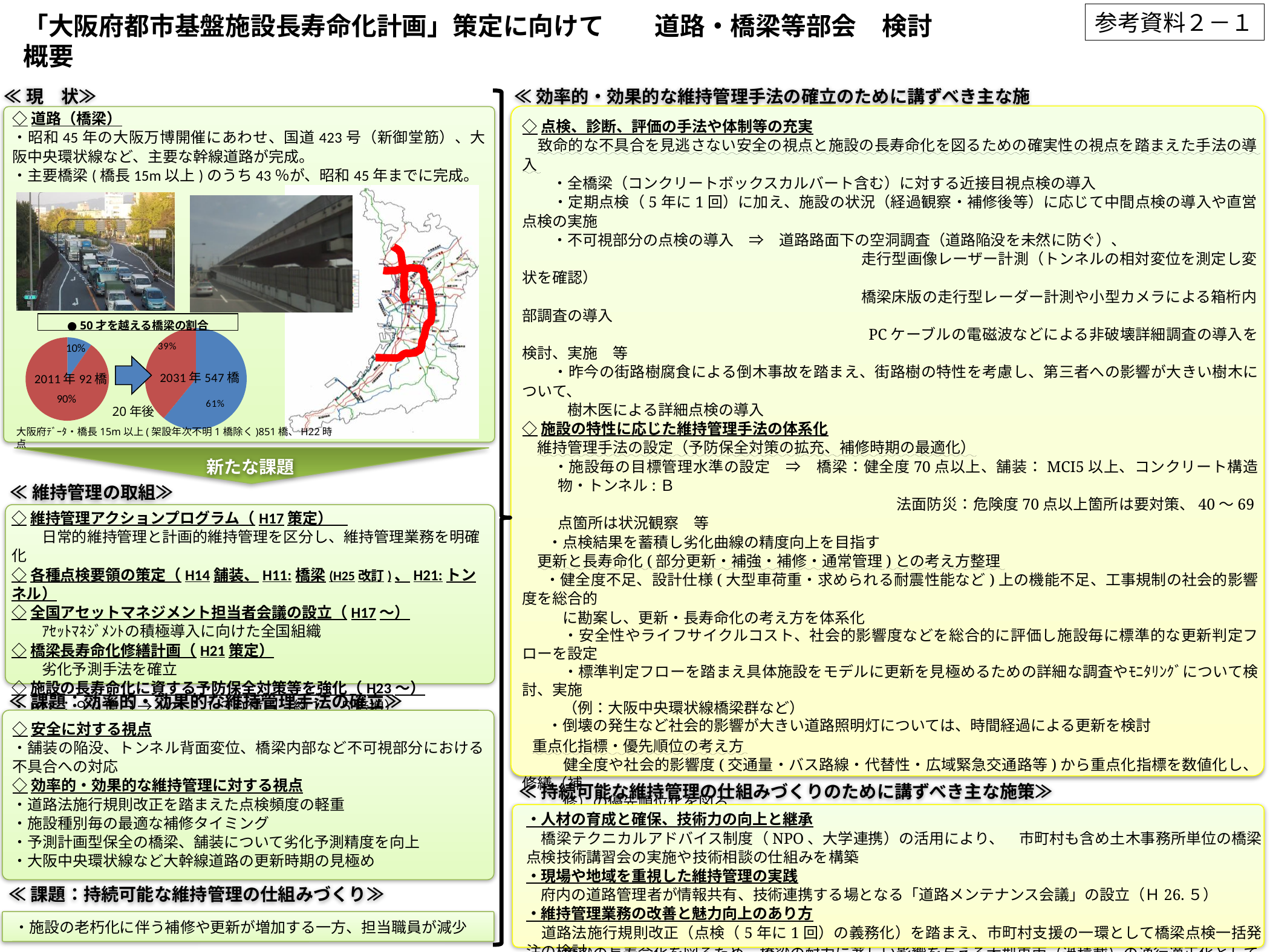
Which pie chart has the larger blue slice, the 2011年 chart or the 2031年 chart? 2031年 What kind of charts are shown under the heading "50才を越える橋梁の割合"? pie charts What is the difference in percentage points between the blue slice in the 2031年 pie chart and the blue slice in the 2011年 pie chart? 51 What is the number of bridges labelled in the centre of the right pie chart for 2031年? 547橋 What is the heading printed above the two pie charts? ● 50才を越える橋梁の割合 In the right pie chart (2031年), what percentage is shown for the blue slice? 61% In the right pie chart (2031年), what percentage is shown for the red slice? 39% How many pie charts are shown under the heading "50才を越える橋梁の割合"? 2 In the left pie chart (2011年), what percentage is shown for the red slice? 90% What is the number of bridges labelled in the centre of the left pie chart for 2011年? 92橋 How many slices does each pie chart under "50才を越える橋梁の割合" have? 2